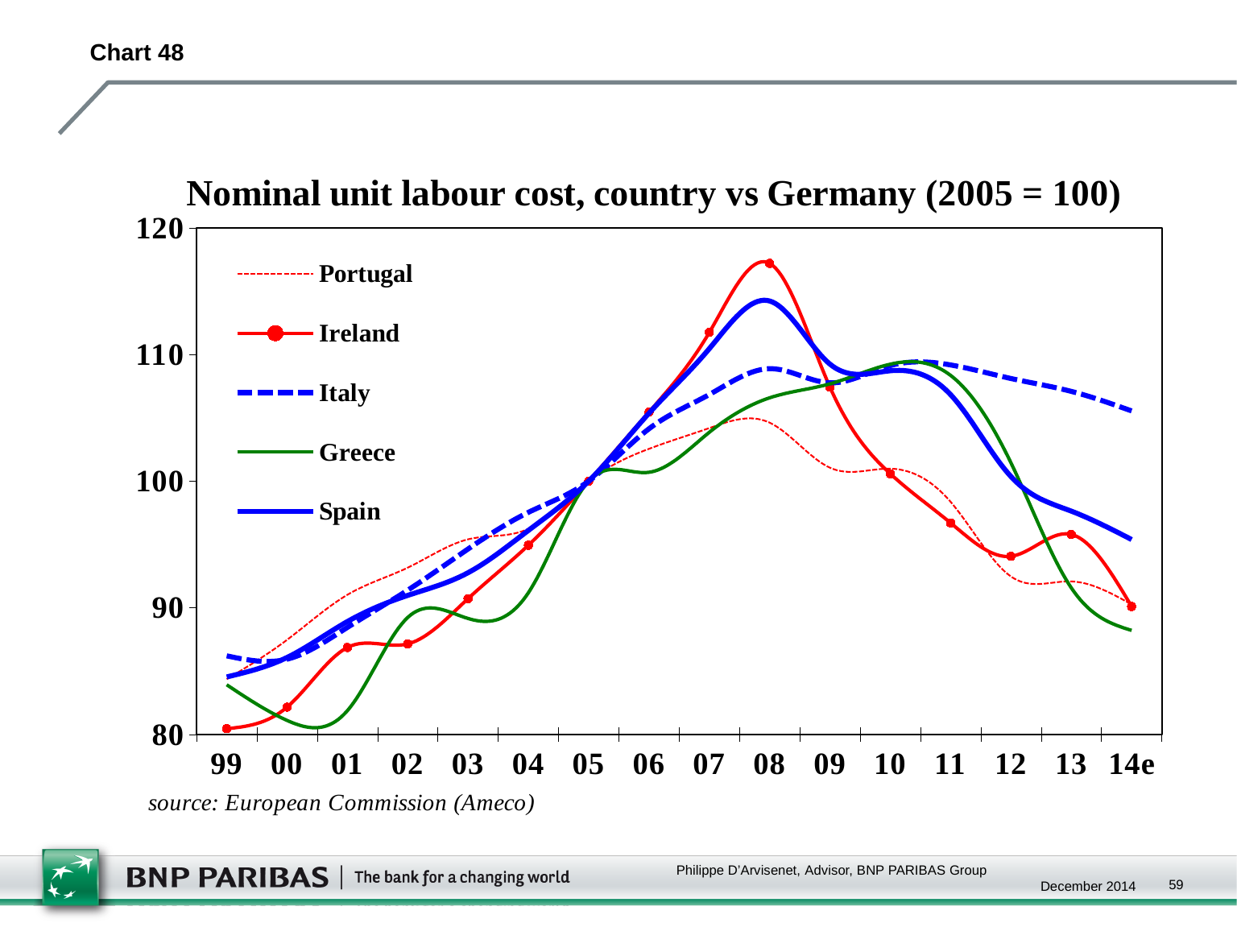
Is the value for Greece in 14e greater or less than 90? less How many years are marked along the x axis? 16 What is the value for Spain in 05? 100 In 14e, which is higher, Italy or Greece? Italy Which country has the lowest value in 99? Ireland What is the title of the chart? Nominal unit labour cost, country vs Germany (2005 = 100) What kind of chart is shown on the slide? line chart How many series does the legend list? 5 Which country has the highest value in 08? Ireland Is the value for Italy in 14e greater or less than 100? greater Does the Greece line rise or fall from 11 to 14e? fall Is the value for Ireland in 08 greater or less than 110? greater